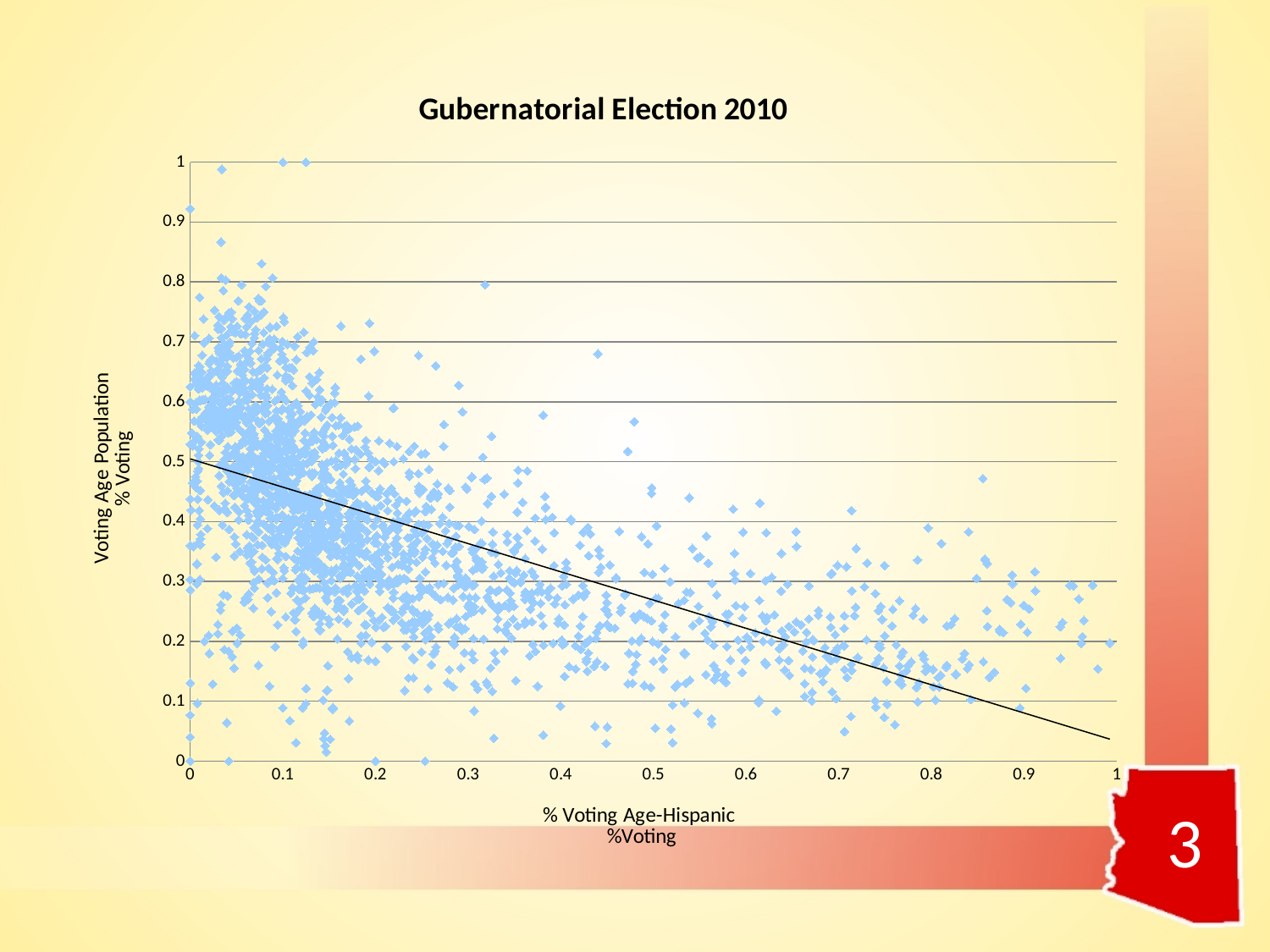
Is the trend line's value at x = 0.2 greater or less than 0.3? greater Is the trend line's value at x = 0.5 greater or less than 0.4? less What is the title of the chart? Gubernatorial Election 2010 What is the label of the x axis? % Voting Age-Hispanic %Voting Is the trend line's value at x = 0 greater or less than 0.4? greater Do the plotted values generally rise or fall as % Voting Age-Hispanic increases along the x axis? fall Does the fitted trend line slope upward or downward from left to right? downward What kind of chart is shown on the slide? scatter plot What is the highest value shown on the y axis? 1